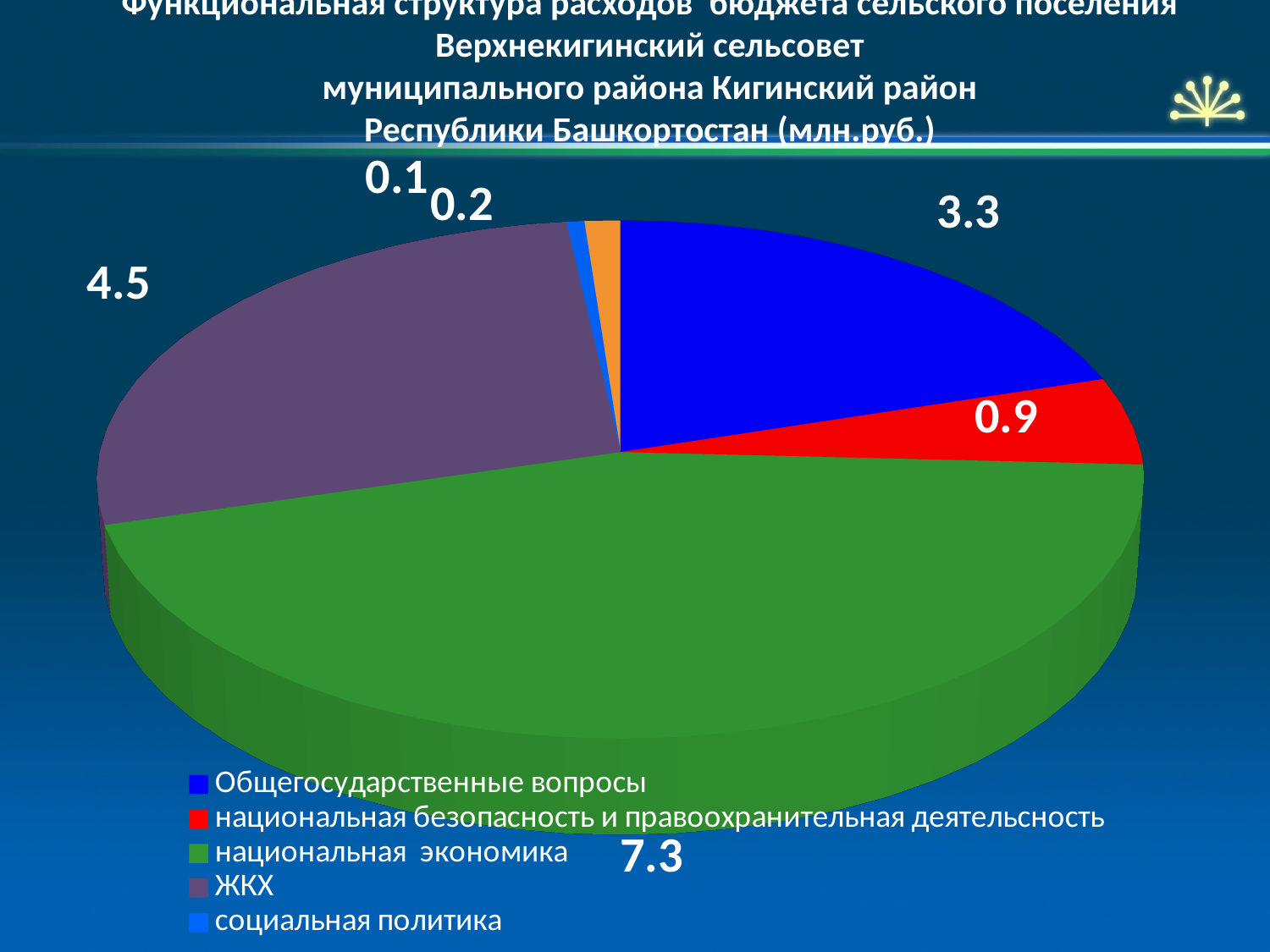
What colour is the slice for национальная экономика? green Which category has the largest slice of the pie? национальная экономика Which legend category has the smallest slice of the pie? социальная политика What is the value for Общегосударственные вопросы? 3.3 What is the value for социальная политика? 0.1 What is the difference between the values for национальная экономика and ЖКХ? 2.8 How many entries does the legend list? 5 What is the value for ЖКХ? 4.5 What is the value for национальная безопасность и правоохранительная деятельность? 0.9 Which is larger, the value for ЖКХ or the value for Общегосударственные вопросы? ЖКХ What kind of chart is shown on the slide? pie chart What is the value for национальная экономика? 7.3